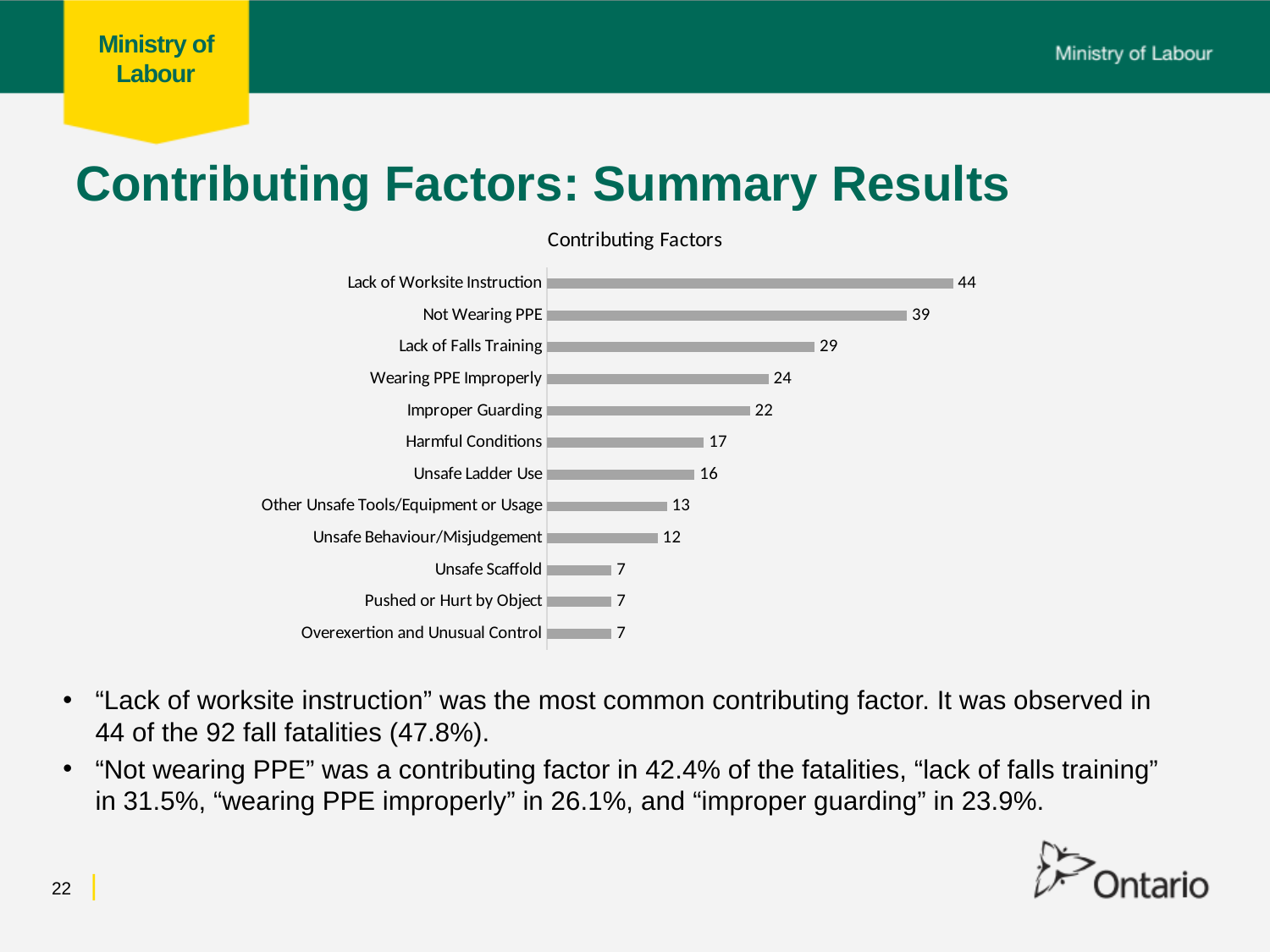
How many contributing factors have a value of 7? 3 What is the title of the chart? Contributing Factors Which contributing factor has the highest value? Lack of Worksite Instruction What is the value for Improper Guarding? 22 How many contributing factors are shown in the chart? 12 What is the difference between the values for Wearing PPE Improperly and Unsafe Scaffold? 17 What is the difference between the values for Not Wearing PPE and Lack of Falls Training? 10 Which is larger, the value for Harmful Conditions or the value for Unsafe Behaviour/Misjudgement? Harmful Conditions What is the value for Unsafe Ladder Use? 16 What is the value for Lack of Worksite Instruction? 44 What kind of chart is shown on the slide? Bar chart What is the value for Other Unsafe Tools/Equipment or Usage? 13